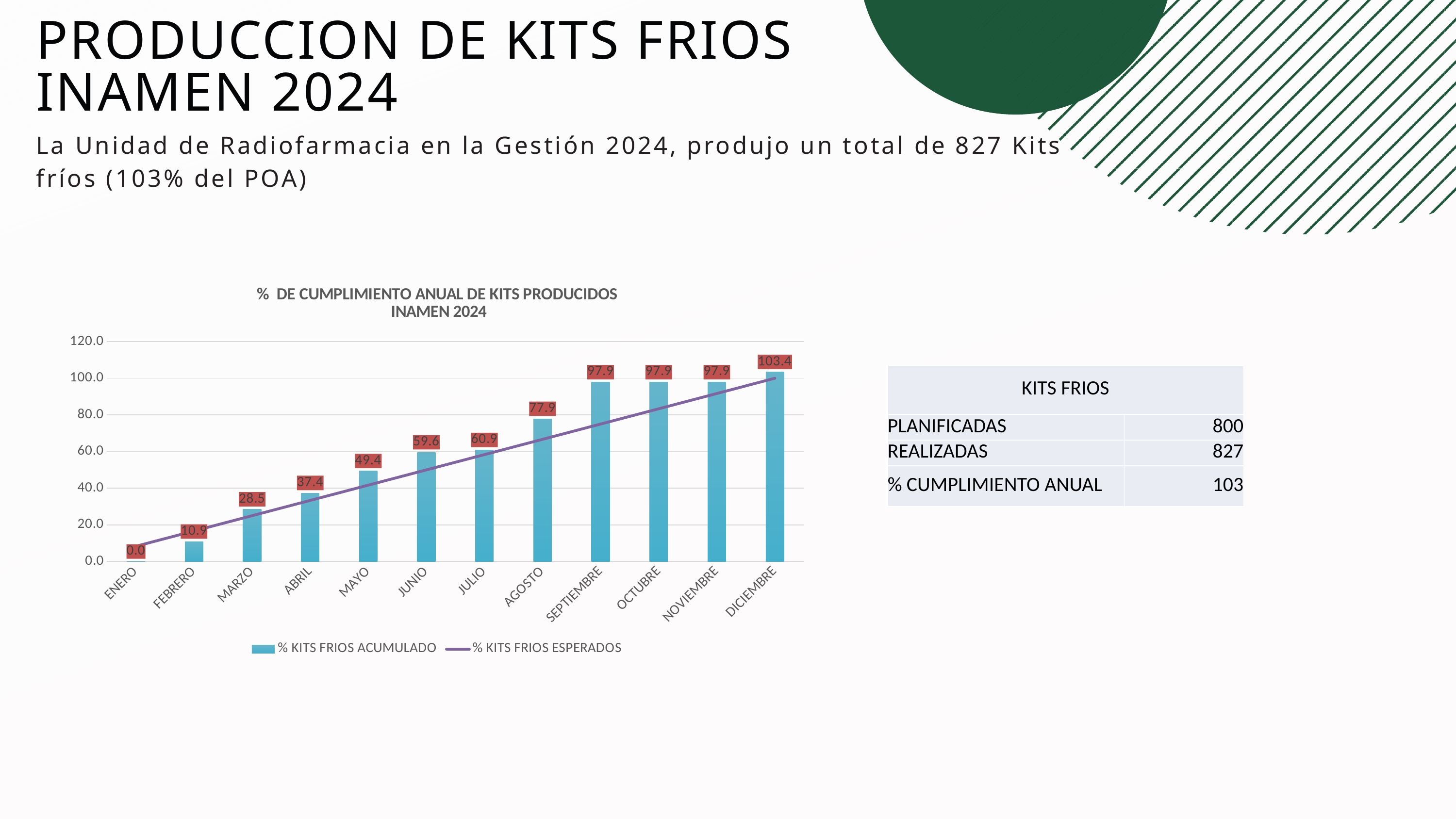
Which month has the highest % KITS FRIOS ACUMULADO value? DICIEMBRE What is the % KITS FRIOS ACUMULADO value for MAYO? 49.4 What kind of chart is shown on the slide? A bar chart combined with a line chart How many series does the chart legend list? 2 How many months are shown on the x axis of the chart? 12 Is the % KITS FRIOS ESPERADOS line value at SEPTIEMBRE greater or less than 80? less Do the % KITS FRIOS ACUMULADO bars rise or fall from ENERO to DICIEMBRE? Rise Which month has the lowest % KITS FRIOS ACUMULADO value? ENERO Which has a larger % KITS FRIOS ACUMULADO value, ABRIL or FEBRERO? ABRIL What is the % KITS FRIOS ACUMULADO value for AGOSTO? 77.9 What is the difference between the % KITS FRIOS ACUMULADO values for JUNIO and MARZO? 31.1 What is the % KITS FRIOS ACUMULADO value for DICIEMBRE? 103.4